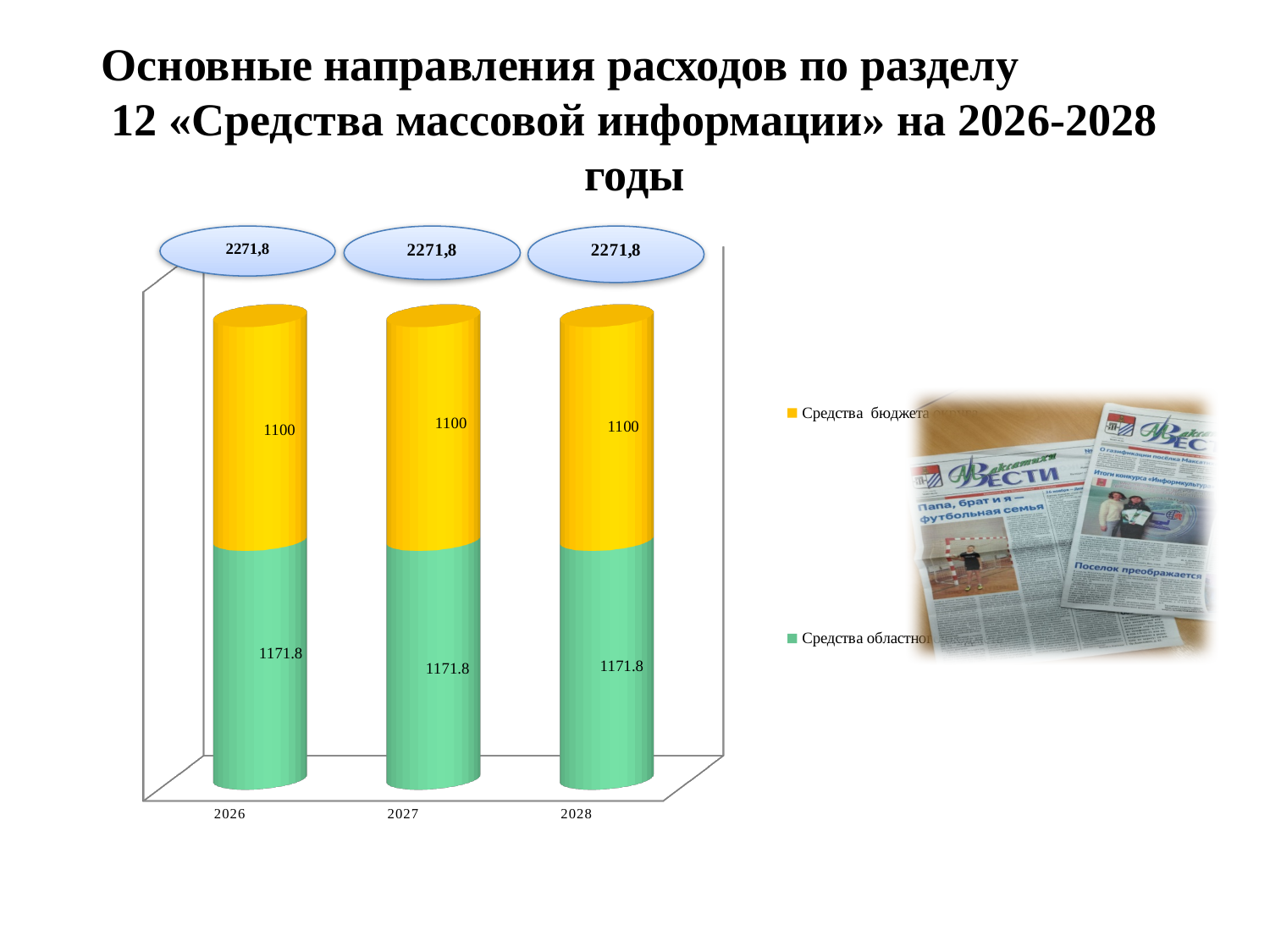
What is the total shown above the bar for 2027? 2271,8 How many years are shown on the x axis of the chart? 3 What kind of chart is shown on the slide? bar chart What is the value of the yellow segment for 2028? 1100 Do the totals of the bars rise, fall or stay the same from 2026 to 2028? stay the same What is the difference between the green and yellow segments for 2026? 71.8 What is the value of the green segment for 2028? 1171.8 What is the value of the green segment for 2027? 1171.8 What is the value of the yellow segment for 2026? 1100 Which colour represents the series at the bottom of each stacked bar? green How many series does the chart's legend list? 2 Which is larger for 2028, the green segment or the yellow segment? green segment